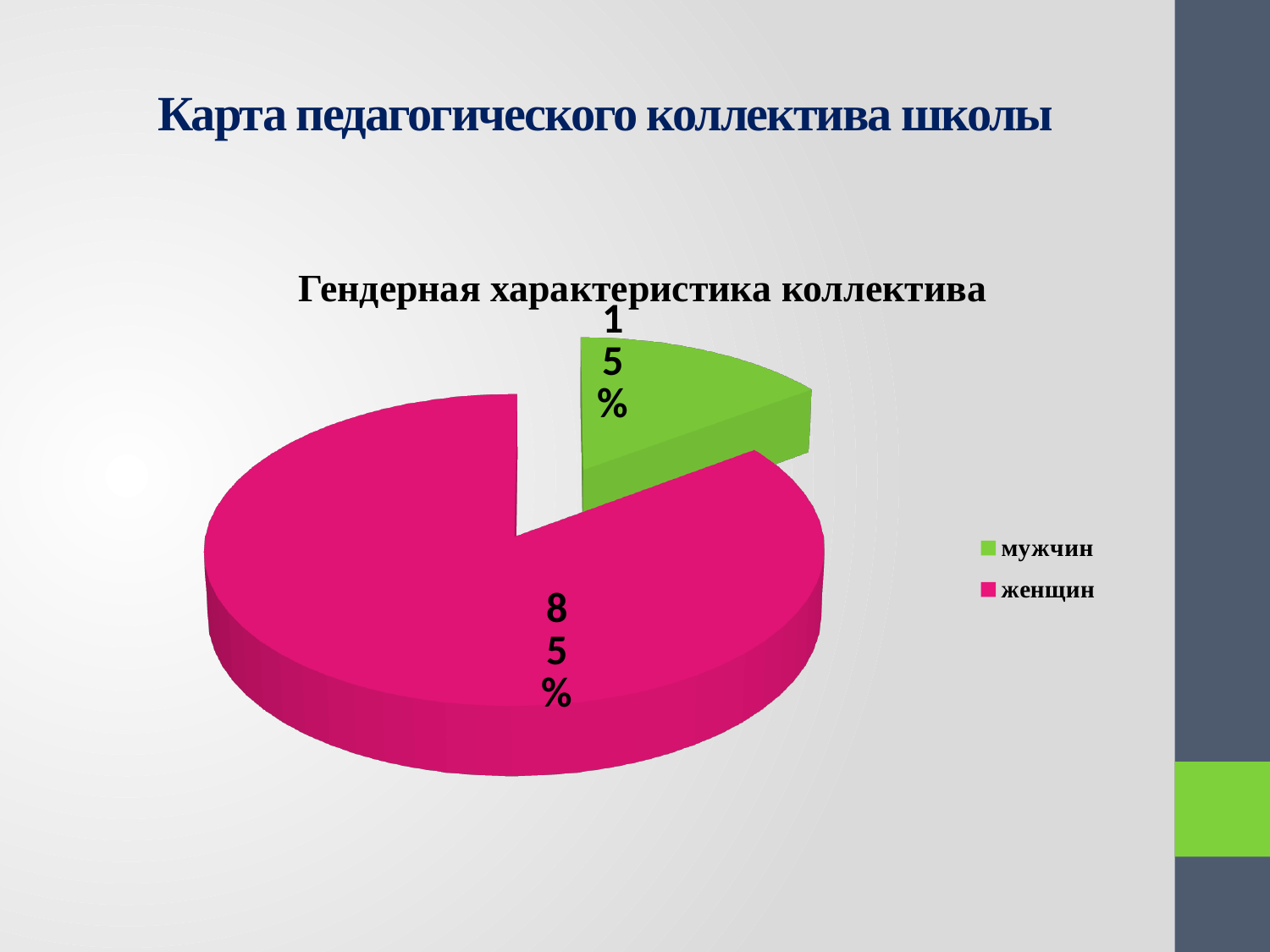
Which is larger, the share for мужчин or the share for женщин? женщин What colour is the slice for мужчин? Green What is the difference in percentage points between женщин and мужчин? 70 What percentage of the staff is shown for женщин? 85% How many entries does the legend list? 2 How many categories does the pie chart show? 2 Which category has the smallest share of the pie? мужчин What is the total of the two slices shown in the pie chart? 100% Which category has the largest share of the pie? женщин What kind of chart is shown on the slide? Pie chart What is the title of the chart? Гендерная характеристика коллектива What percentage of the staff is shown for мужчин? 15%